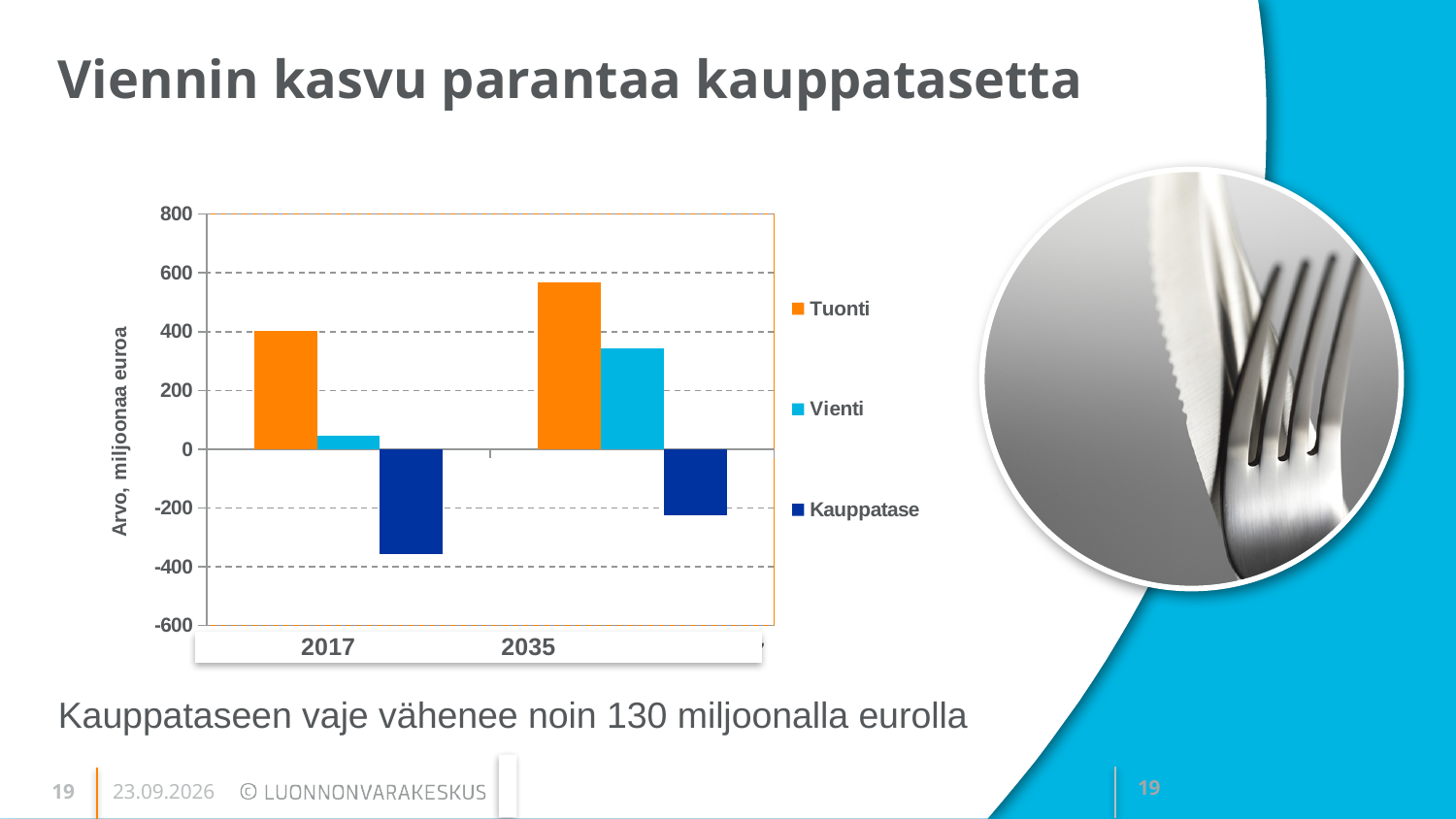
Which series has the highest value in 2035? Tuonti How many categories are shown on the x axis of the chart? 2 Is the value for Kauppatase in 2017 greater or less than -200? less Does the Vienti value rise or fall from 2017 to 2035? rise Is the Vienti value larger in 2017 or in 2035? 2035 What kind of chart is shown on the slide? bar chart Is the value for Tuonti in 2035 greater or less than 400? greater Which series has the lowest value in 2017? Kauppatase What is the title of the chart's vertical axis? Arvo, miljoonaa euroa Is the value for Vienti in 2017 greater or less than 200? less How many series does the chart's legend list? 3 Is the Tuonti value larger in 2017 or in 2035? 2035